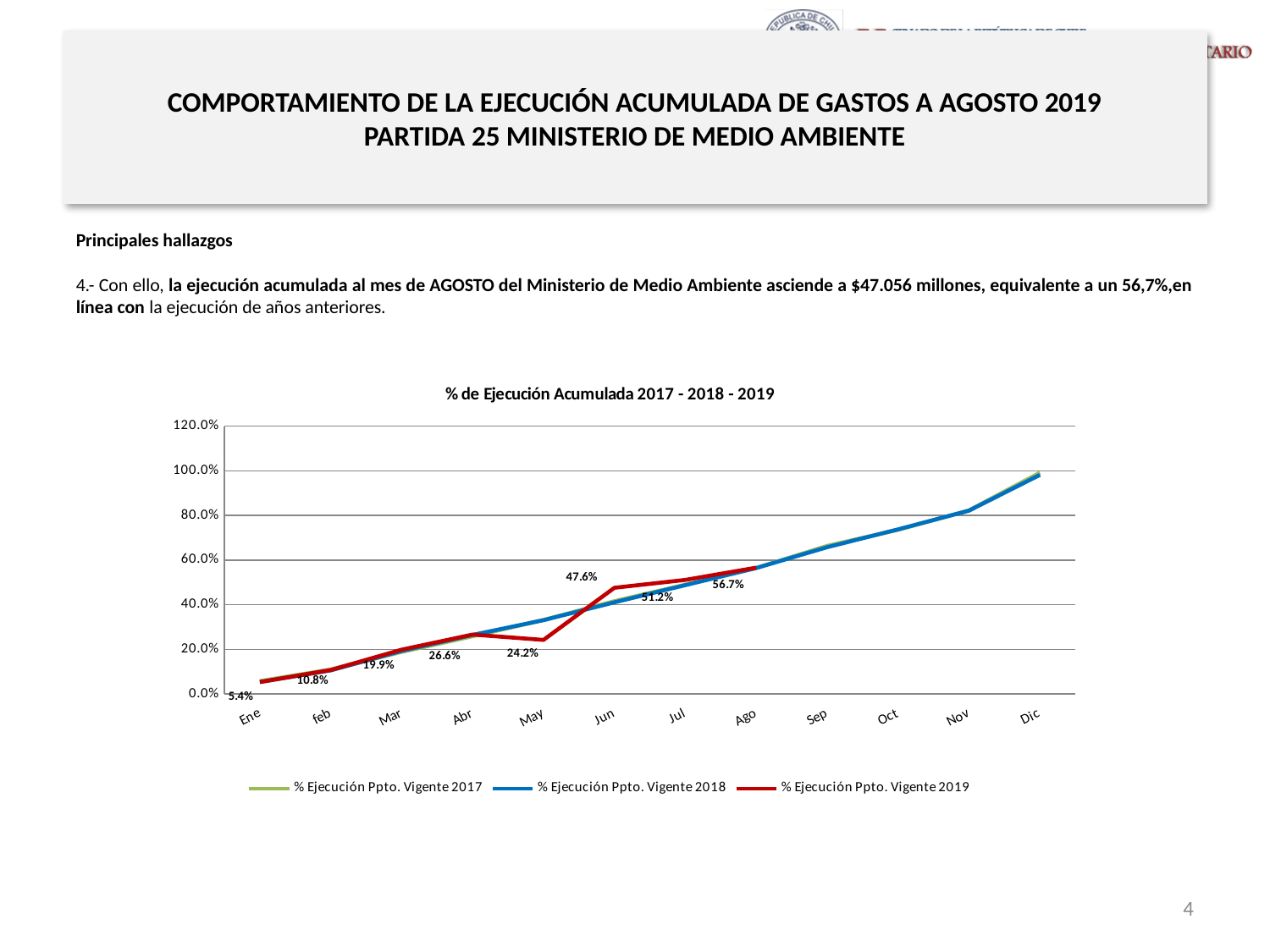
How many series does the chart legend list? 3 What kind of chart is shown on the slide? line chart What is the difference between the 2019 values for Ago and Jul? 5.5 percentage points What is the value of % Ejecución Ppto. Vigente 2019 for Jun? 47.6% How many months are shown along the x axis of the chart? 12 Do the values of % Ejecución Ppto. Vigente 2018 rise or fall from Ene to Dic? rise For the 2019 series, which is larger: the value for Abr or the value for May? Abr What is the title of the chart? % de Ejecución Acumulada 2017 - 2018 - 2019 What is the value of % Ejecución Ppto. Vigente 2019 for Ene? 5.4% Is the value of % Ejecución Ppto. Vigente 2018 for Dic greater or less than 80.0%? greater Is the value of % Ejecución Ppto. Vigente 2018 for Sep greater or less than 80.0%? less What is the value of % Ejecución Ppto. Vigente 2019 for Ago? 56.7%